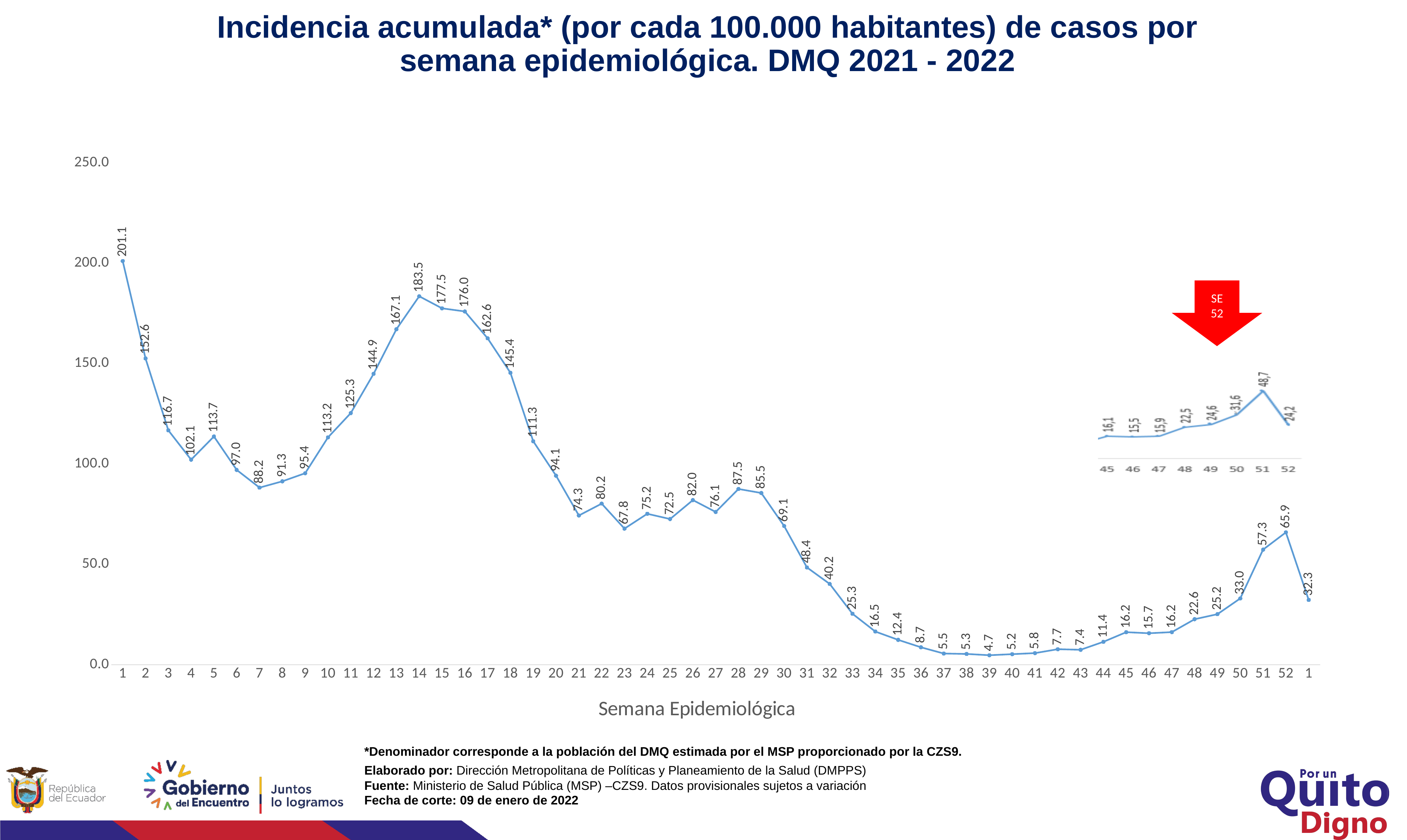
In the main chart, what is the cumulative incidence value for epidemiological week 14? 183.5 In the main chart, is the value for week 31 greater or less than 50.0? less In the main chart, what is the value for epidemiological week 52? 65.9 In the main chart, what is the value plotted for epidemiological week 39? 4.7 In the main chart, do the values rise or fall from week 34 to week 39? fall In the main chart, which epidemiological week has the lowest value? 39 In the main chart, how many data points are plotted along the x axis? 53 In the small inset chart at the top right, which week has the highest value? 51 In the main chart, which is larger, the value for week 15 or the value for week 16? week 15 In the main chart, which epidemiological week has the highest value? 1 In the main chart, what is the difference between the values for week 52 and week 51? 8.6 What type of chart is the main chart on the slide? line chart